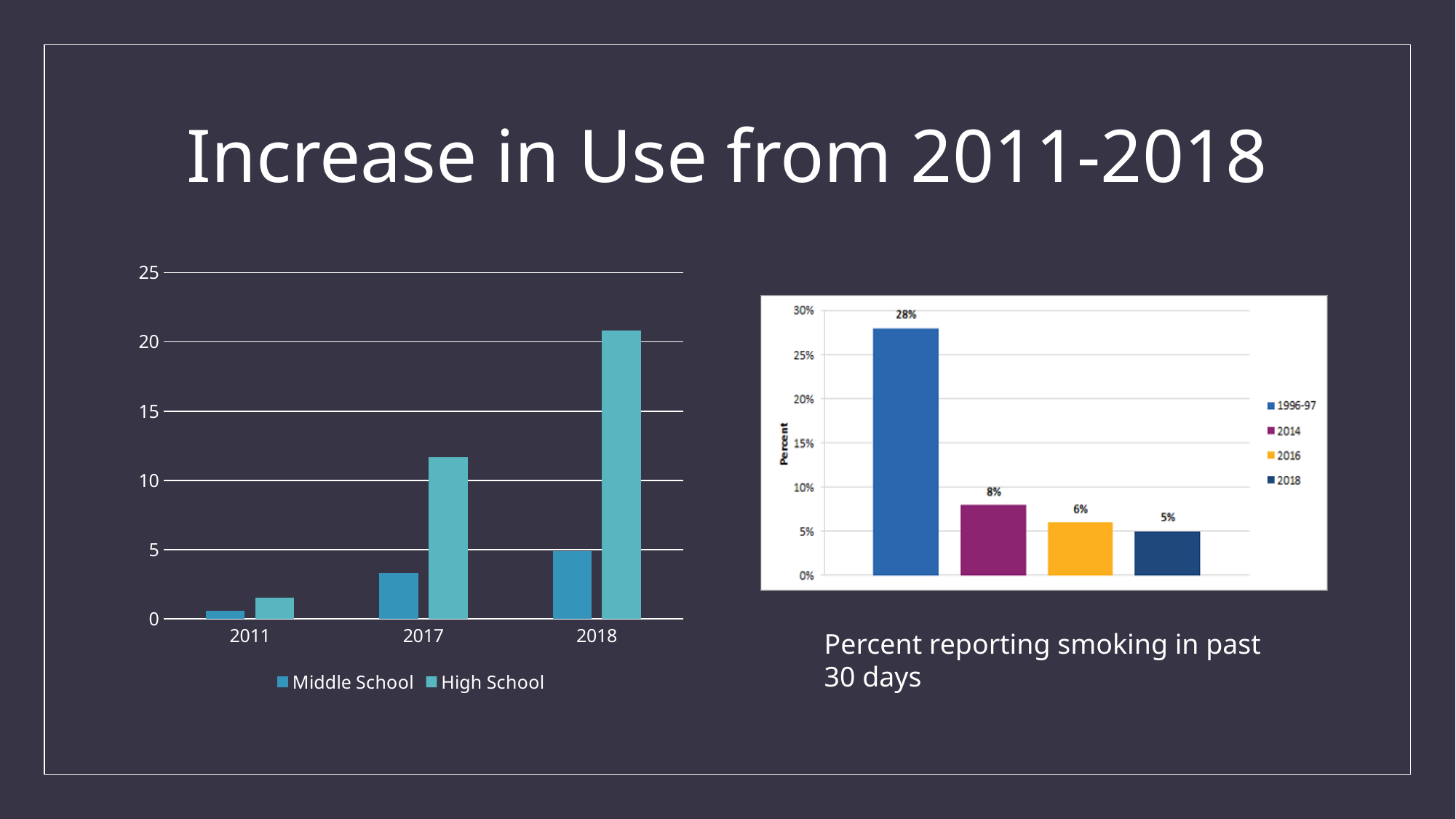
In the left chart, is the High School value for 2017 greater or less than 10? greater In the chart 'Percent reporting smoking in past 30 days', what is the difference between the 1996-97 value and the 2018 value? 23 percentage points In the left chart, is the Middle School value for 2017 greater or less than 5? less In the left chart, how many years are shown on the x axis? 3 In the left chart, is the High School value for 2018 greater or less than 15? greater What kind of chart is the chart 'Percent reporting smoking in past 30 days'? bar chart In the left chart, how many series does the legend list? 2 In the left chart, do the High School values rise or fall from 2011 to 2018? rise In the chart 'Percent reporting smoking in past 30 days', what is the value for 1996-97? 28% In the left chart, which year has the highest High School value? 2018 In the chart 'Percent reporting smoking in past 30 days', what is the value for 2016? 6% In the chart 'Percent reporting smoking in past 30 days', which period has the lowest value? 2018